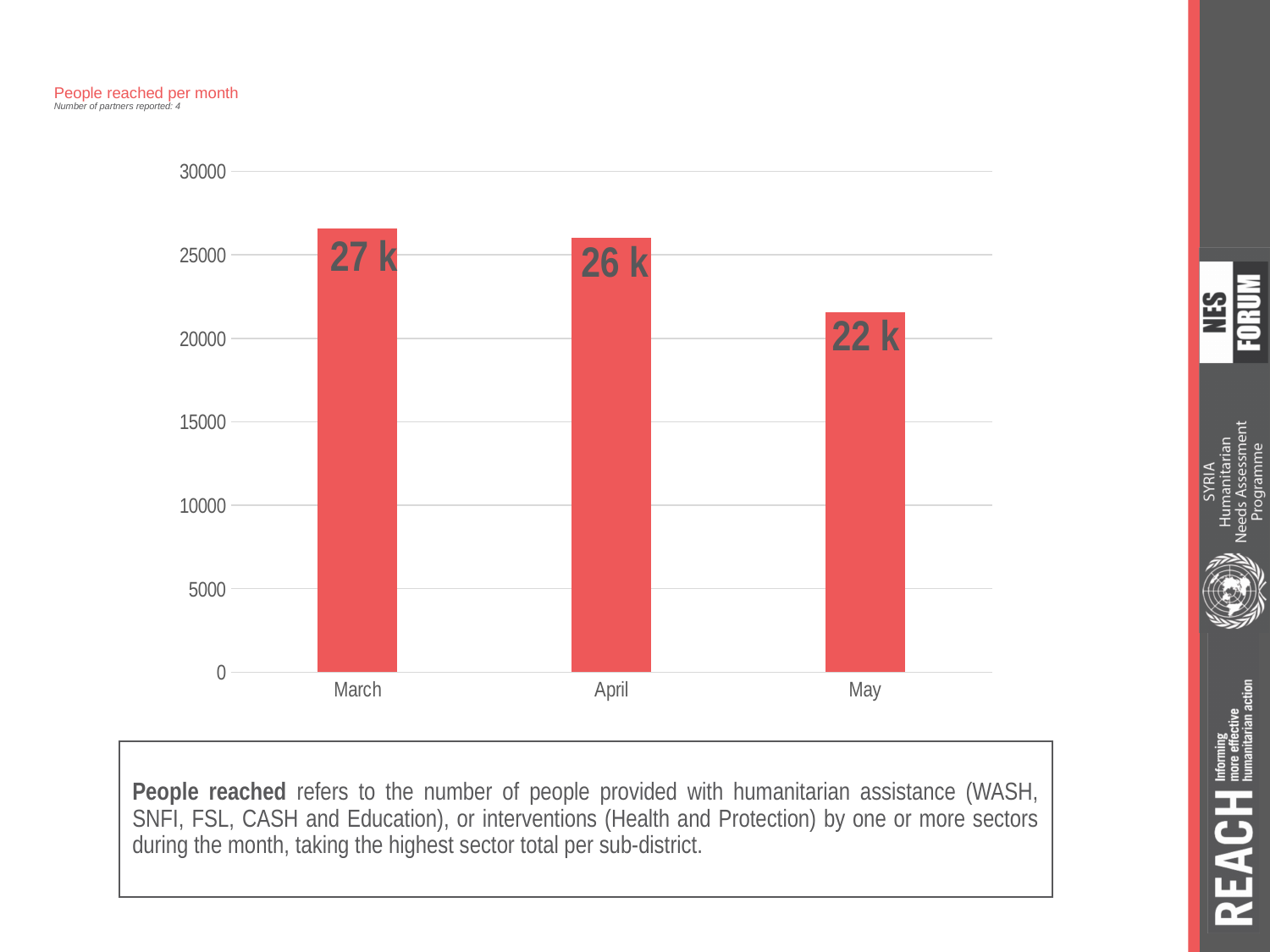
What is the value for May in the People reached per month chart? 22 k What is the difference between the values for March and May? 5 k Which month has the highest number of people reached? March Which month has the lowest number of people reached? May What is the value for March in the People reached per month chart? 27 k What is the value for April in the People reached per month chart? 26 k Which is larger, the value for April or the value for May? April How many months are shown on the x axis of the chart? 3 Do the values rise or fall from March to May? fall Is the value for March greater or less than 25000? greater Is the value for May greater or less than 25000? less What kind of chart is shown on the slide? bar chart